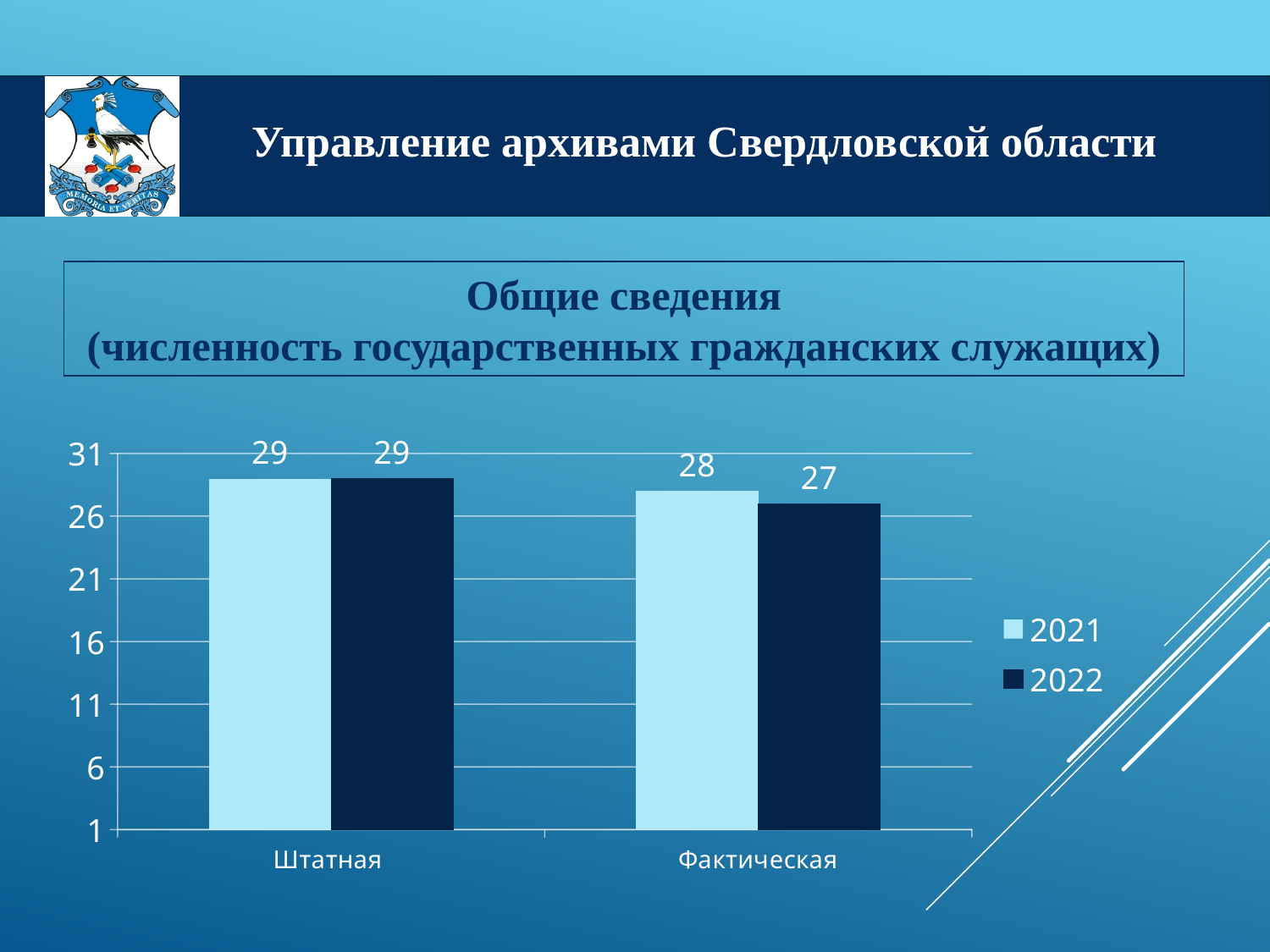
What is the value for Штатная in 2022? 29 What is the difference between the 2021 and 2022 values for Фактическая? 1 What is the value for Штатная in 2021? 29 What kind of chart is shown on the slide? bar chart Which is larger for Фактическая: the 2021 value or the 2022 value? 2021 What is the value for Фактическая in 2022? 27 How many categories are shown on the x axis? 2 Which series is shown in dark navy blue? 2022 Which category has the lowest value in the 2022 series? Фактическая What is the value for Фактическая in 2021? 28 What is the difference between the Штатная and Фактическая values in 2022? 2 How many series does the legend list? 2